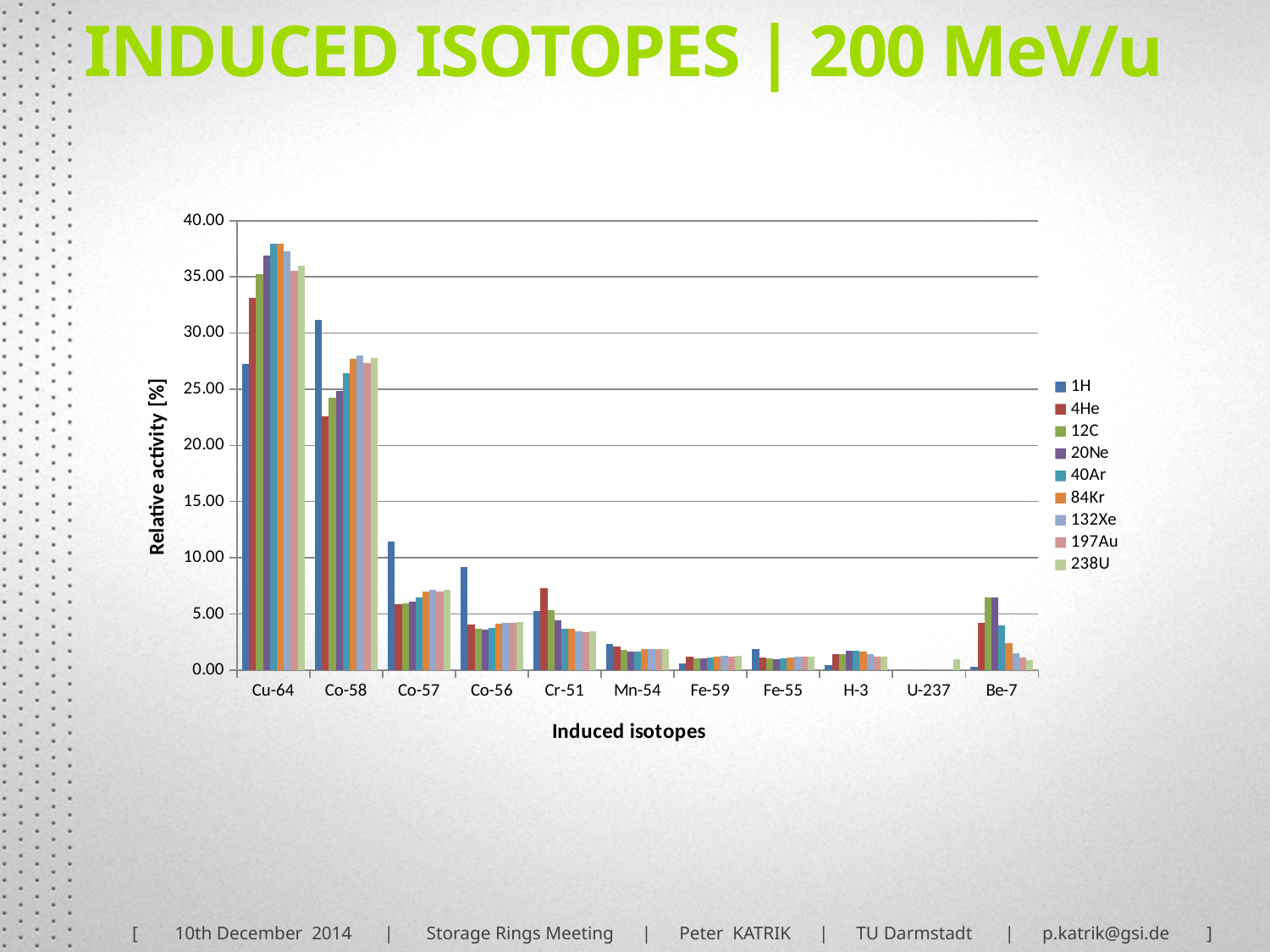
Which is larger: the 1H value for Cu-64 or the 1H value for Co-58? Co-58 How many induced isotope categories are shown on the x axis? 11 What kind of chart is shown on the slide? bar chart Which series has the highest value for Cr-51? 4He Which induced isotope has the highest relative activity overall? Cu-64 What is the title of the y axis? Relative activity [%] Is the 1H value for Co-58 greater or less than 30.00? greater Is the 1H value for Cu-64 greater or less than 30.00? less Is the 4He value for Co-58 greater or less than 25.00? less Which series has the highest value for Co-57? 1H How many series does the legend list? 9